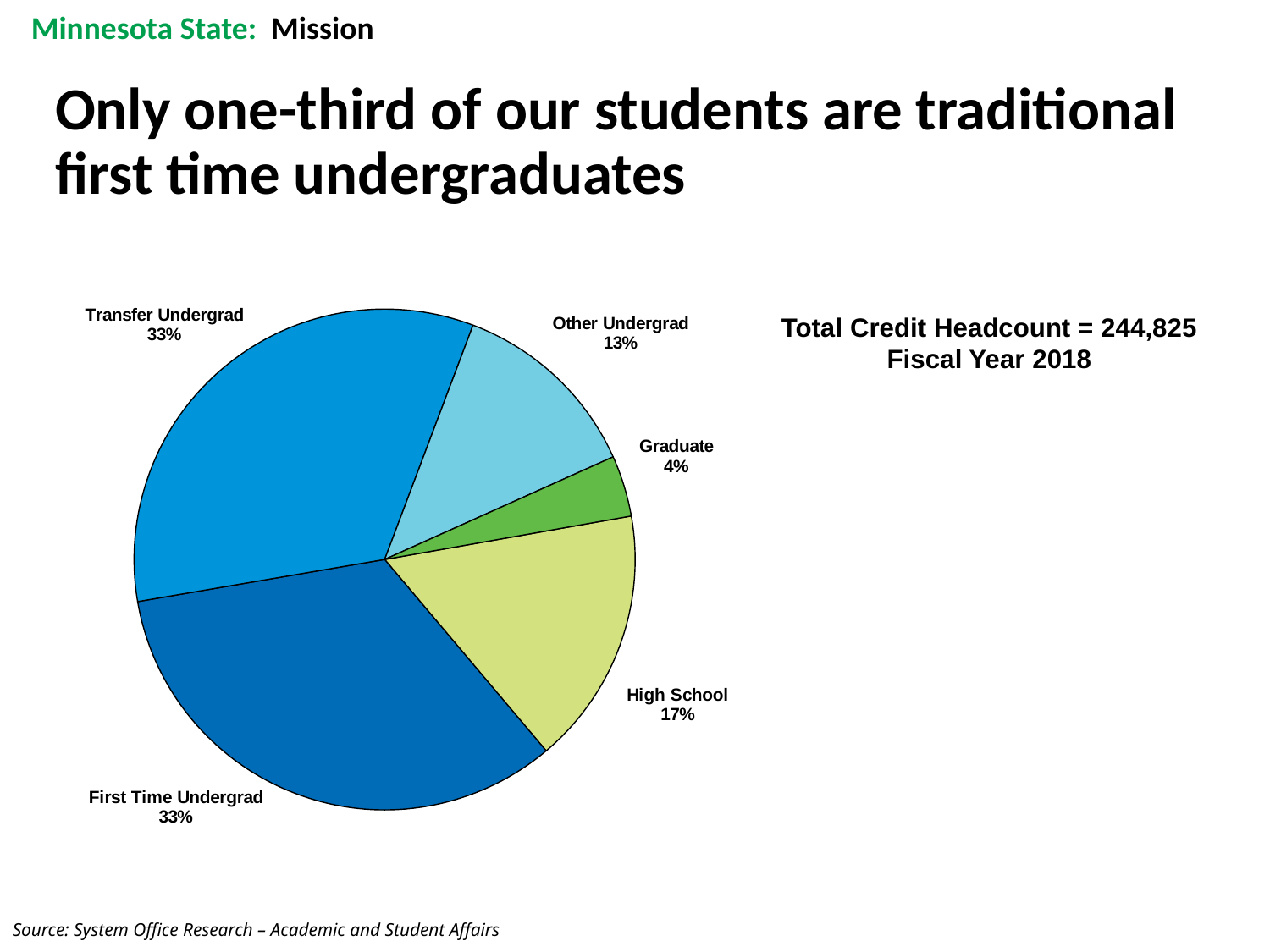
Which fiscal year does the pie chart cover? Fiscal Year 2018 What share of the pie is High School? 17% What share of the pie is Graduate? 4% What kind of chart is shown on the slide? pie chart What is the difference in percentage points between High School and Other Undergrad? 4 Which category has the smallest slice of the pie? Graduate How many slices does the pie chart have? 5 What share of the pie is Other Undergrad? 13% What is the difference in percentage points between First Time Undergrad and High School? 16 What total credit headcount is stated next to the pie chart? 244,825 Which is larger, the High School slice or the Graduate slice? High School